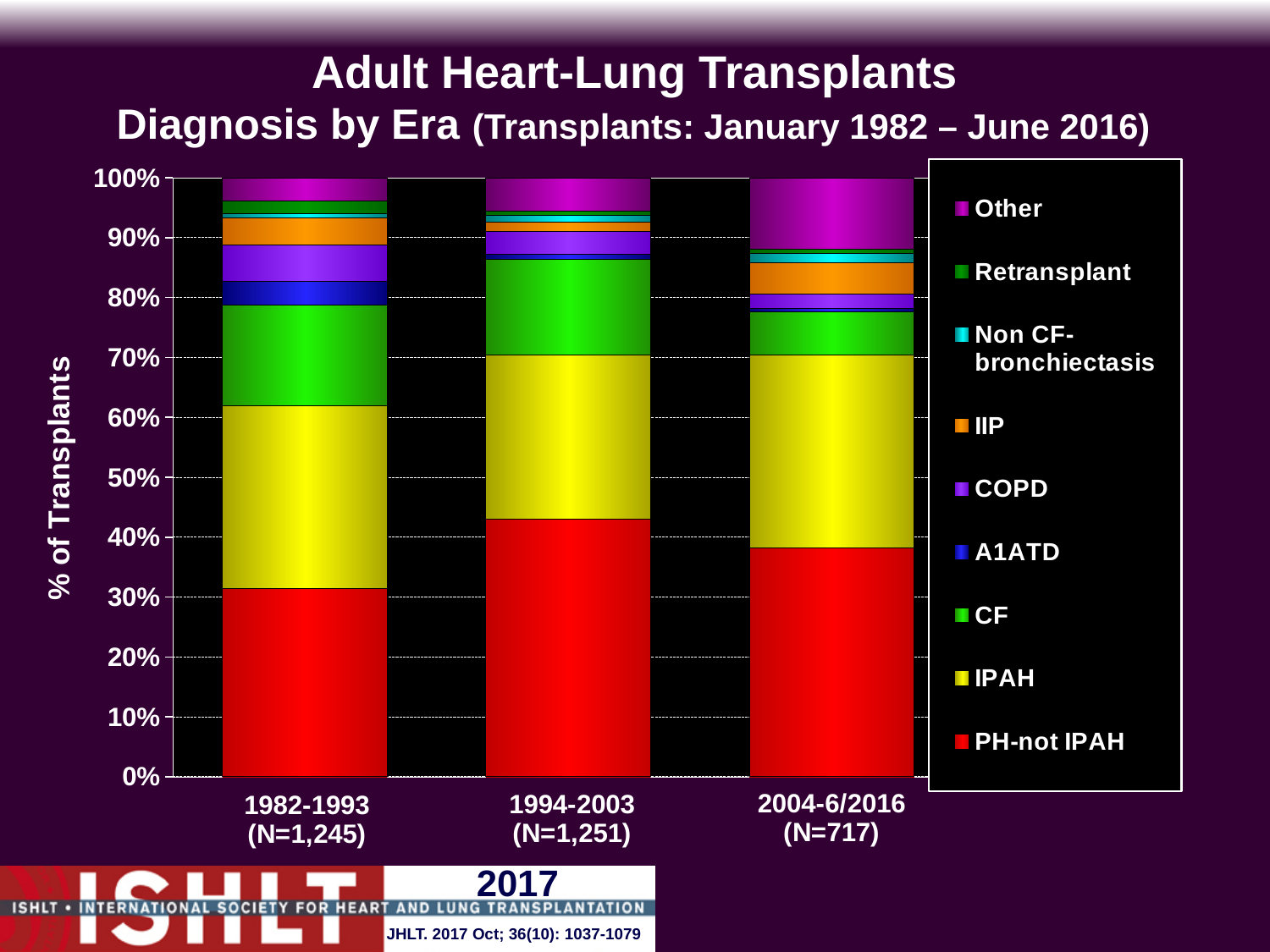
What is the y-axis label of the chart? % of Transplants How many era categories are shown on the x axis? 3 Is the PH-not IPAH share for 1982-1993 greater or less than 40%? less What is the N shown for the 2004-6/2016 era? 717 Is the PH-not IPAH share for 1994-2003 greater or less than 40%? greater How many diagnosis series does the legend list? 9 What kind of chart is shown on the slide? Stacked bar chart Which diagnosis is listed at the bottom of the legend? PH-not IPAH Does the Other share rise or fall across the eras from 1982-1993 to 2004-6/2016? rise Which era has the smallest CF share? 2004-6/2016 What is the N shown for the 1994-2003 era? 1,251 Which era has the largest PH-not IPAH share? 1994-2003